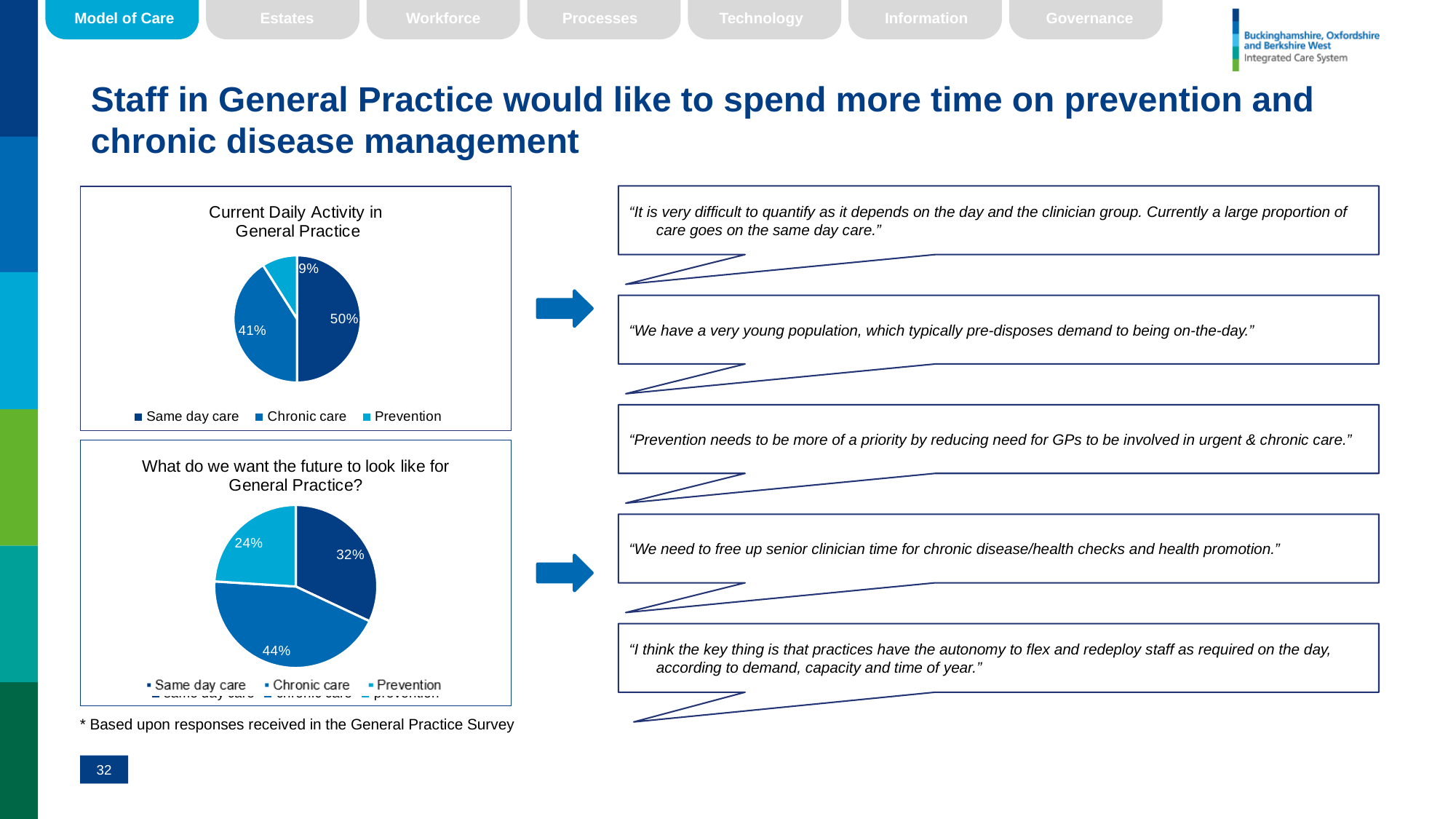
In the 'What do we want the future to look like for General Practice?' chart, what is the difference between the Chronic care and Same day care shares? 12% In the 'Current Daily Activity in General Practice' chart, which category has the largest share? Same day care What type of chart is 'Current Daily Activity in General Practice'? pie chart In the 'Current Daily Activity in General Practice' chart, what is the difference between the Same day care and Chronic care shares? 9% In the 'What do we want the future to look like for General Practice?' chart, is the Same day care share larger or smaller than the Chronic care share? smaller In the 'What do we want the future to look like for General Practice?' chart, what share is Chronic care? 44% In the 'What do we want the future to look like for General Practice?' chart, what share is Prevention? 24% In the 'Current Daily Activity in General Practice' chart, what share is Prevention? 9% In the 'Current Daily Activity in General Practice' chart, what share is Same day care? 50% How many categories does the legend of the 'Current Daily Activity in General Practice' chart list? 3 In the 'What do we want the future to look like for General Practice?' chart, which category has the largest share? Chronic care In the 'Current Daily Activity in General Practice' chart, which category has the smallest share? Prevention